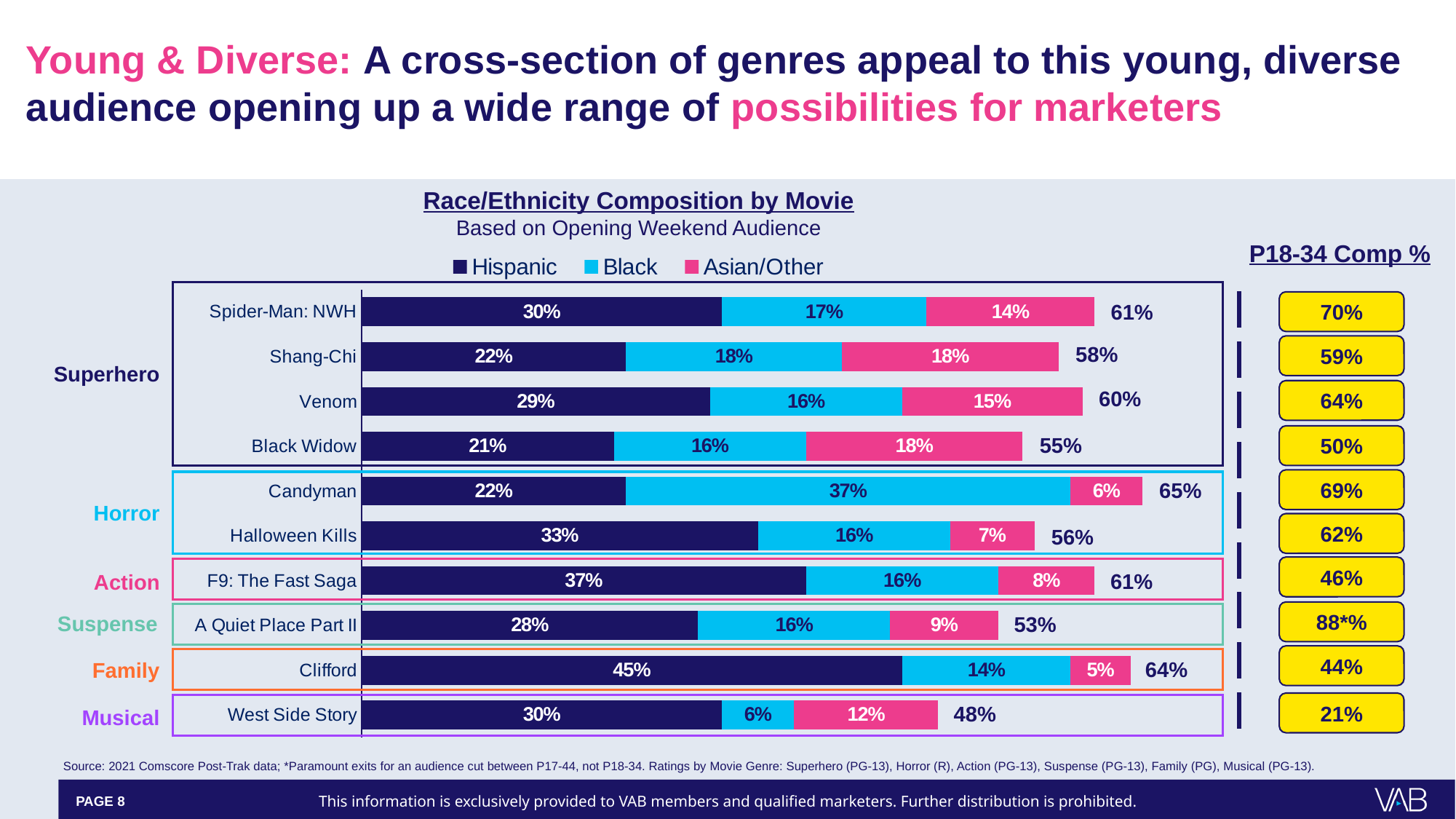
Which is larger, the Asian/Other share for Spider-Man: NWH or the Asian/Other share for Halloween Kills? Spider-Man: NWH What is the difference between the Hispanic share for F9: The Fast Saga and the Hispanic share for Black Widow? 16% What is the Hispanic share of the opening weekend audience for Clifford? 45% How many movies are shown in the Race/Ethnicity Composition by Movie chart? 10 What is the P18-34 Comp % value shown for Spider-Man: NWH? 70% Which movie has the lowest Black share of its opening weekend audience? West Side Story Which movie has the highest Hispanic share of its opening weekend audience? Clifford What is the Black share of the opening weekend audience for Candyman? 37% What is the Asian/Other share of the opening weekend audience for Shang-Chi? 18% How many series does the legend of the Race/Ethnicity Composition by Movie chart list? 3 What is the total race/ethnicity composition shown at the end of the bar for Candyman? 65% What kind of chart is used to show Race/Ethnicity Composition by Movie? Stacked bar chart